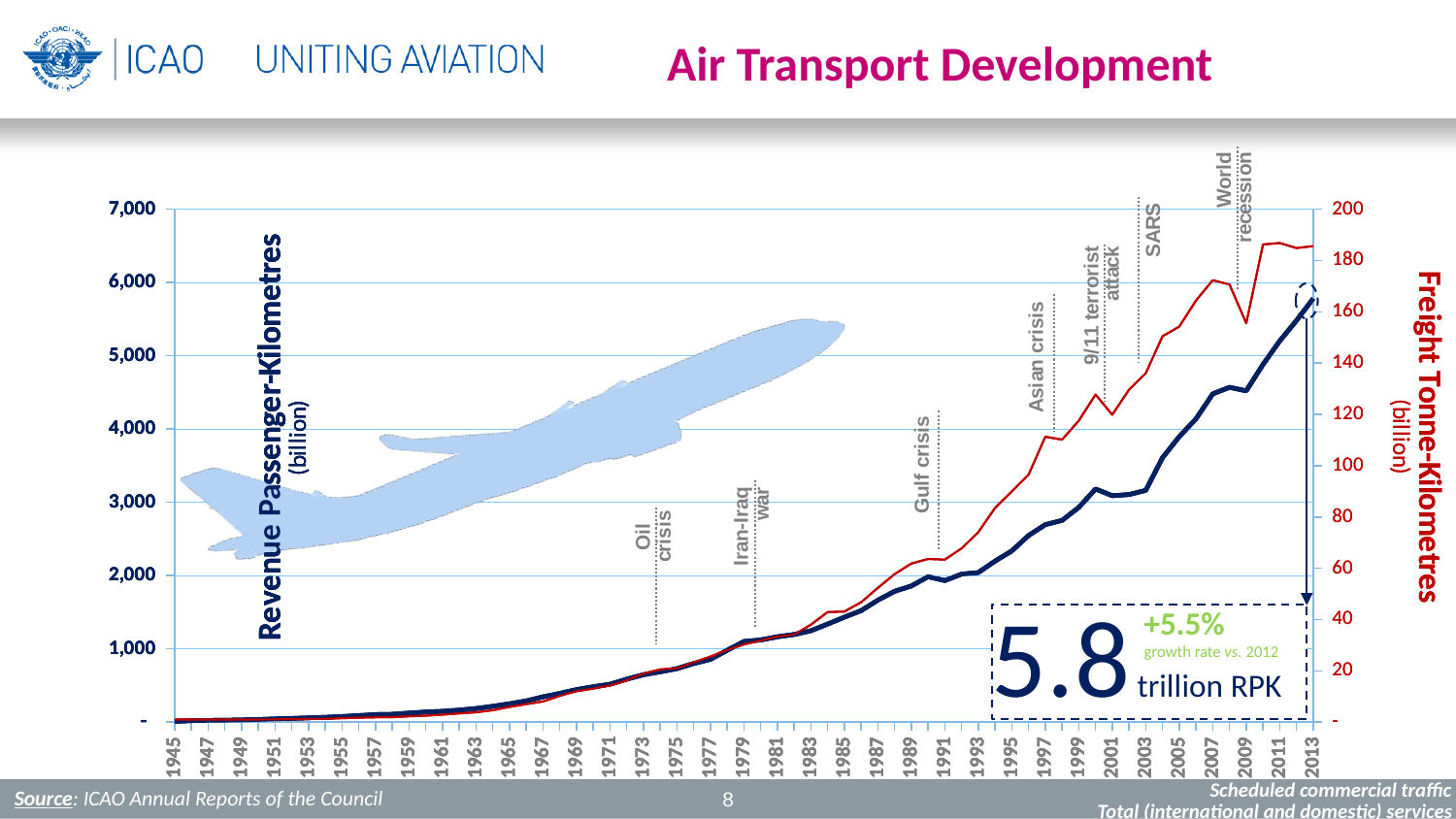
What quantity is plotted on the left vertical axis? Revenue Passenger-Kilometres (billion) Is the Revenue Passenger-Kilometres value for 2013 greater or less than 5,000? greater What kind of chart is shown on the slide? line chart What growth rate vs. 2012 is shown in the callout box? +5.5% Is the Freight Tonne-Kilometres value for 1985 greater or less than 60? less What is the chart's title? Air Transport Development In which year does the Revenue Passenger-Kilometres series reach its highest value? 2013 Do Revenue Passenger-Kilometres generally rise or fall from 1945 to 2013? rise How many crisis or event annotations are marked along the chart? 7 What value of Revenue Passenger-Kilometres is highlighted for 2013? 5.8 trillion RPK Is the Revenue Passenger-Kilometres value for 1995 greater or less than 3,000? less